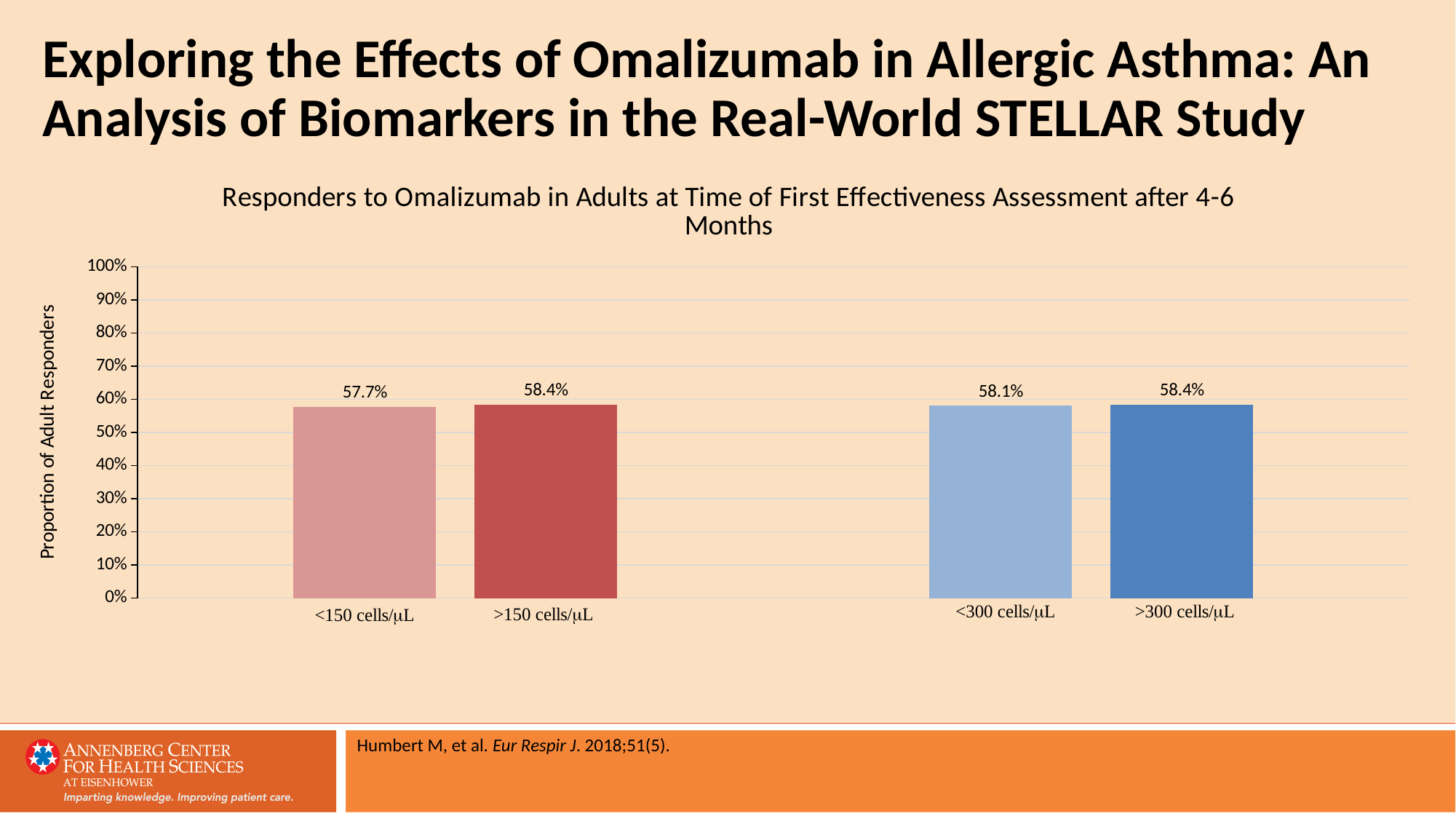
How many bars are plotted in the chart? 4 What is the value for the >150 cells/μL bar? 58.4% What is the value for the >300 cells/μL bar? 58.4% Is the value for <150 cells/μL greater or less than 60%? less Which is larger, the value for <300 cells/μL or the value for >300 cells/μL? >300 cells/μL What is the value for the <150 cells/μL bar? 57.7% What kind of chart is shown on the slide? Bar chart Which category has the lowest proportion of adult responders? <150 cells/μL What is the difference between the >150 cells/μL and <150 cells/μL values? 0.7% Is the value for >300 cells/μL greater or less than 50%? greater What is the label of the vertical axis? Proportion of Adult Responders What is the value for the <300 cells/μL bar? 58.1%